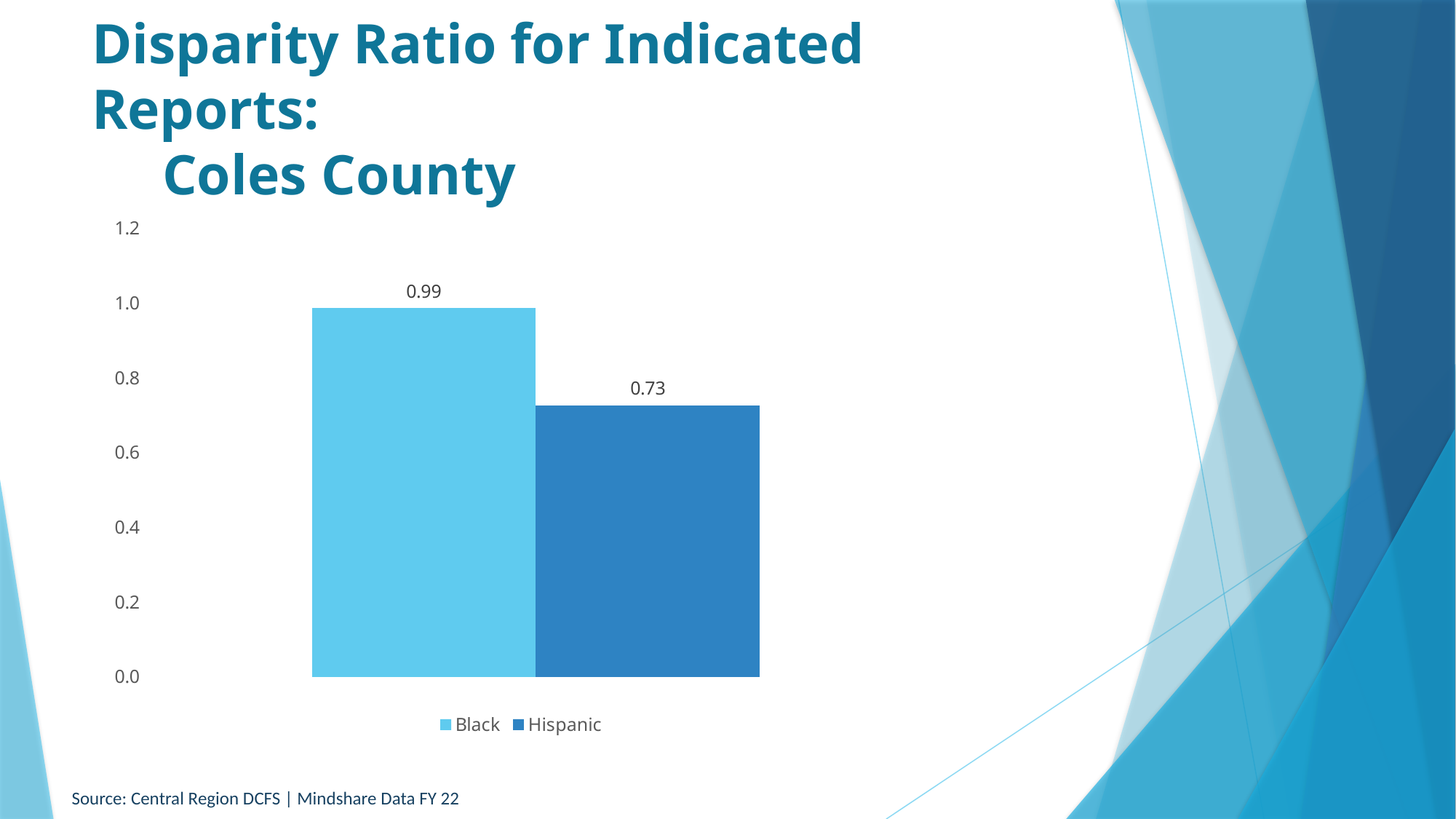
Is the disparity ratio for Black larger or smaller than the ratio for Hispanic? larger Which group has the higher disparity ratio? Black What is the maximum value shown on the vertical axis? 1.2 How many bars are plotted in the chart? 2 Is the value for Hispanic greater or less than 0.8? less What is the difference between the Black and Hispanic disparity ratios? 0.26 What is the disparity ratio for Black? 0.99 How many series does the legend list? 2 What is the disparity ratio for Hispanic? 0.73 Is the value for Black greater or less than 0.8? greater Which group has the lower disparity ratio? Hispanic What kind of chart is shown on the slide? bar chart